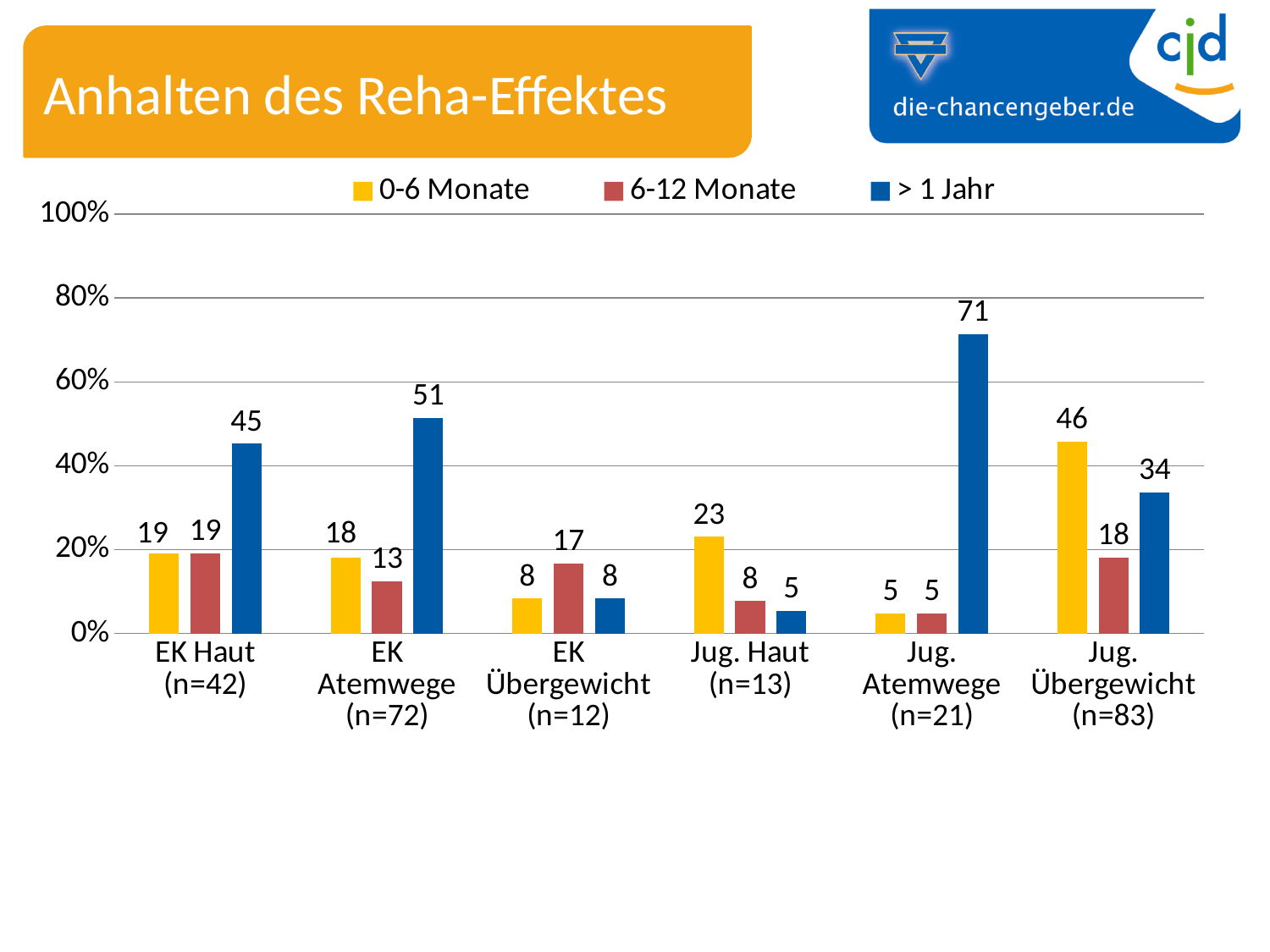
What is the value for "6-12 Monate" in the EK Übergewicht (n=12) category? 17 Which category has the highest value for the "> 1 Jahr" series? Jug. Atemwege (n=21) Which category has the lowest value for the "0-6 Monate" series? Jug. Atemwege (n=21) Is the "> 1 Jahr" value for EK Atemwege (n=72) greater or less than 40%? greater What is the difference between the "> 1 Jahr" value and the "0-6 Monate" value in the Jug. Atemwege (n=21) category? 66 What kind of chart is shown on the slide? bar chart How many series does the legend list? 3 What is the value for "0-6 Monate" in the Jug. Übergewicht (n=83) category? 46 How many categories are shown on the x axis? 6 What is the title of the slide? Anhalten des Reha-Effektes Which is larger in the Jug. Haut (n=13) category: the "0-6 Monate" value or the "> 1 Jahr" value? 0-6 Monate What is the value for "> 1 Jahr" in the EK Haut (n=42) category? 45